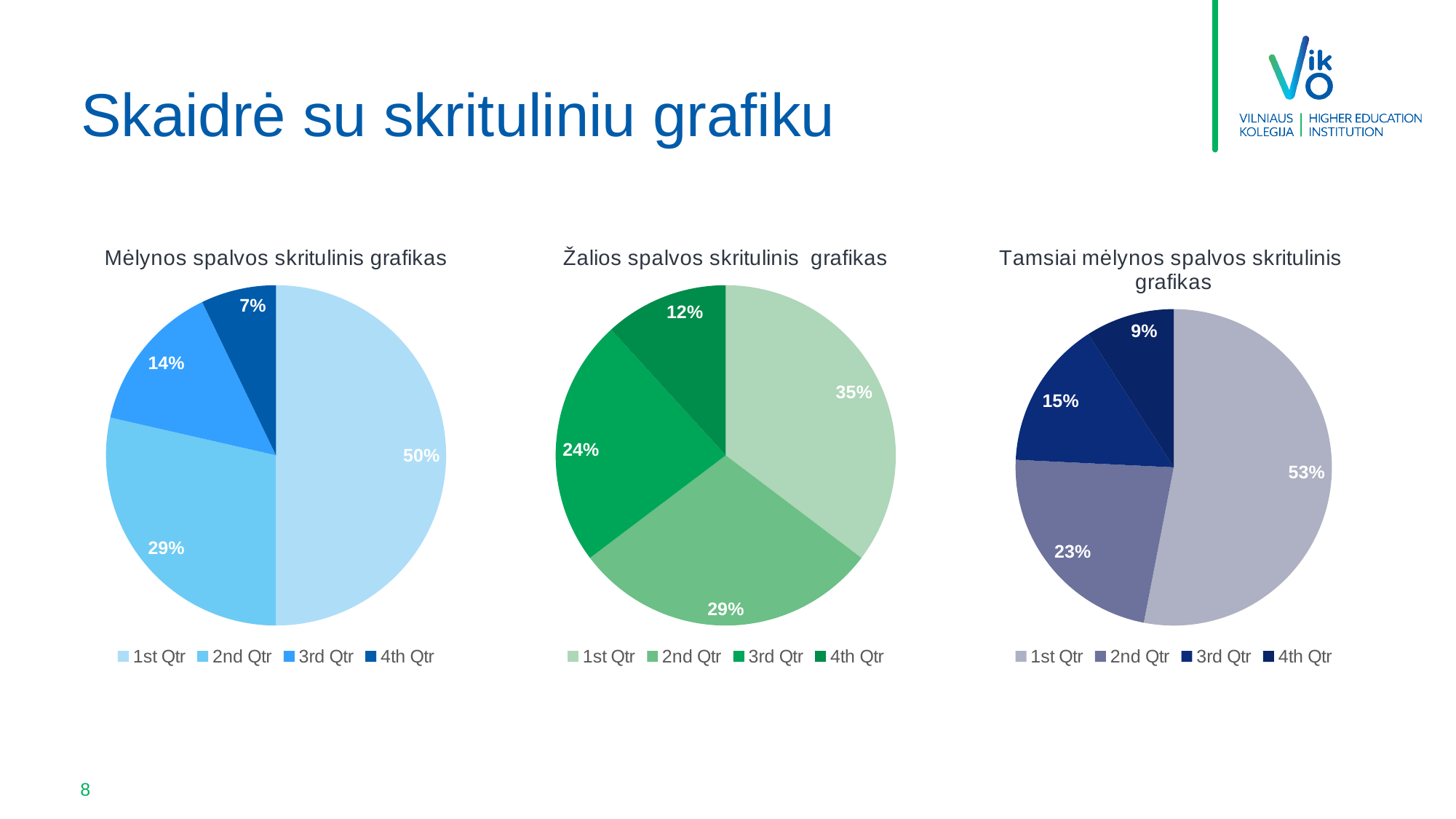
In the chart titled 'Mėlynos spalvos skritulinis grafikas', which quarter has the smallest slice? 4th Qtr In the chart titled 'Žalios spalvos skritulinis grafikas', what is the value for 2nd Qtr? 29% What type of chart is the chart titled 'Žalios spalvos skritulinis grafikas'? Pie chart In the chart titled 'Mėlynos spalvos skritulinis grafikas', what share does 1st Qtr have? 50% In the chart titled 'Žalios spalvos skritulinis grafikas', what is the difference between 1st Qtr and 4th Qtr? 23% In the chart titled 'Mėlynos spalvos skritulinis grafikas', what is the value for 3rd Qtr? 14% In the chart titled 'Tamsiai mėlynos spalvos skritulinis grafikas', what is the difference between 1st Qtr and 2nd Qtr? 30% In the chart titled 'Tamsiai mėlynos spalvos skritulinis grafikas', what is the value for 2nd Qtr? 23% In the chart titled 'Žalios spalvos skritulinis grafikas', which quarter has the largest slice? 1st Qtr How many entries does the legend of the chart titled 'Tamsiai mėlynos spalvos skritulinis grafikas' list? 4 In the chart titled 'Tamsiai mėlynos spalvos skritulinis grafikas', which is larger, 3rd Qtr or 4th Qtr? 3rd Qtr How many slices does the chart titled 'Mėlynos spalvos skritulinis grafikas' have? 4